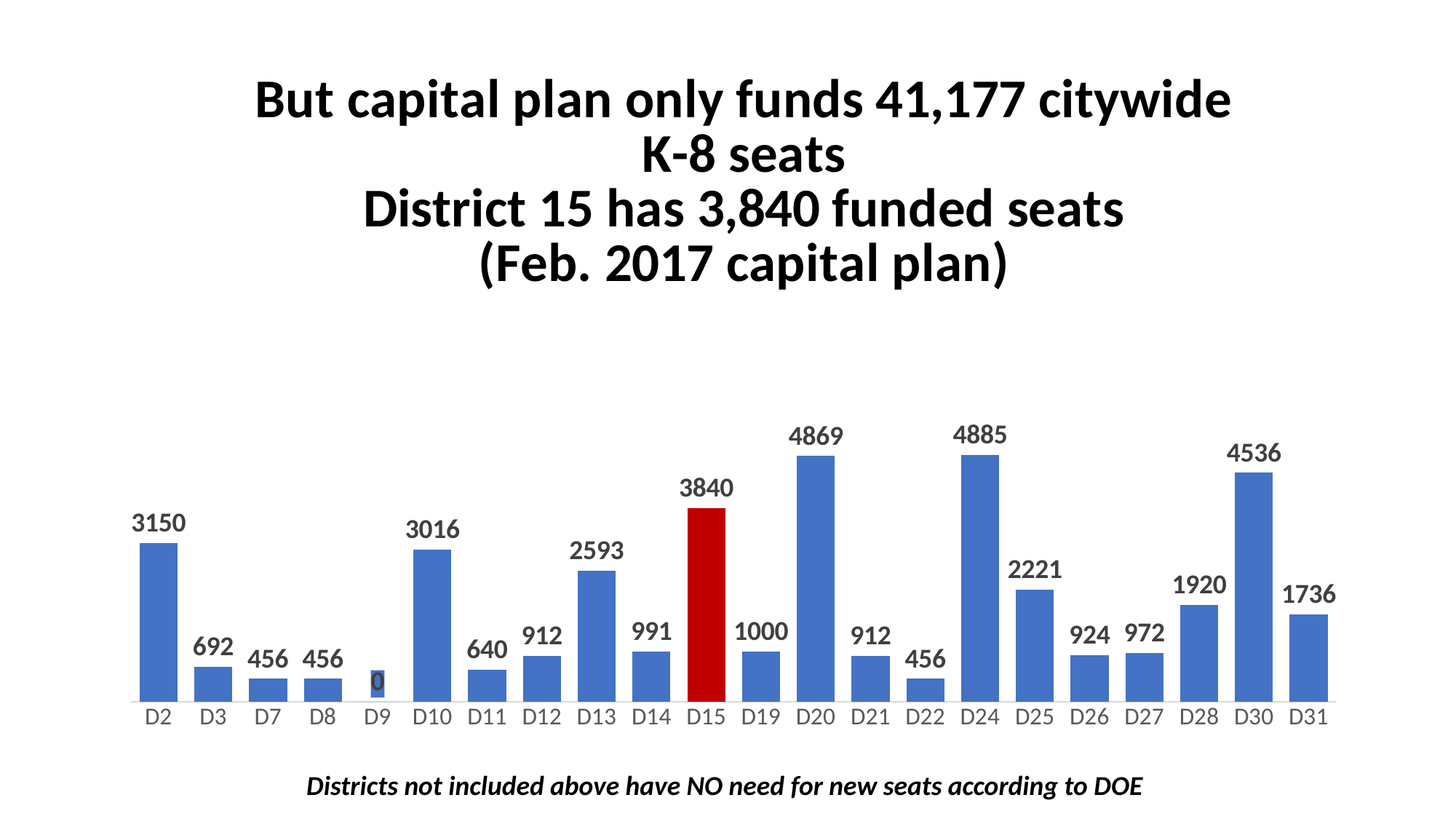
What is the value for D31? 1736 What is the value for D20? 4869 What is the value for D9? 0 What is the difference between the values for D30 and D28? 2616 How many districts are shown on the chart? 22 What is the value for D15? 3840 What is the difference between the values for D15 and D13? 1247 What kind of chart is shown on the slide? Bar chart Which district has the lowest value? D9 Which district's bar is coloured red? D15 Which is larger, the value for D2 or the value for D10? D2 Which district has the highest value? D24